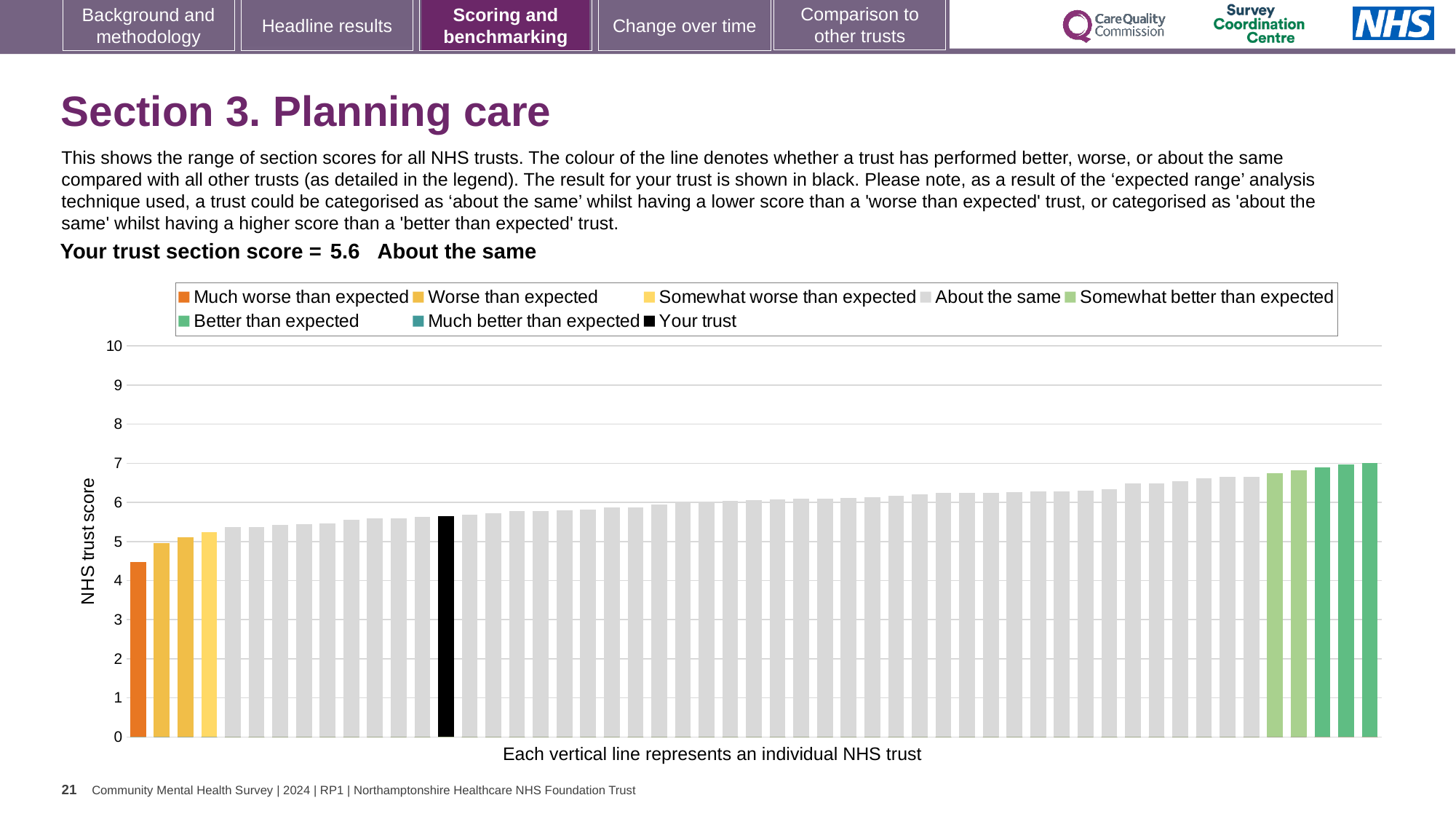
Do the bar values rise or fall from left to right along the x axis? rise How many entries does the chart legend list? 8 What is the label on the vertical axis of the chart? NHS trust score Is the value of the orange 'Much worse than expected' bar greater or less than 5? less What type of chart is shown on the slide? bar chart Which is larger, the orange 'Much worse than expected' bar or the black 'Your trust' bar? Your trust Is the value of the black 'Your trust' bar greater or less than 5? greater Which performance category is your trust placed in for Section 3. Planning care? About the same What is the section score for your trust shown on the slide? 5.6 Is the value of the tallest bar in the chart greater or less than 6? greater Which legend category does the lowest bar in the chart belong to? Much worse than expected How many bars are coloured orange for 'Much worse than expected'? 1